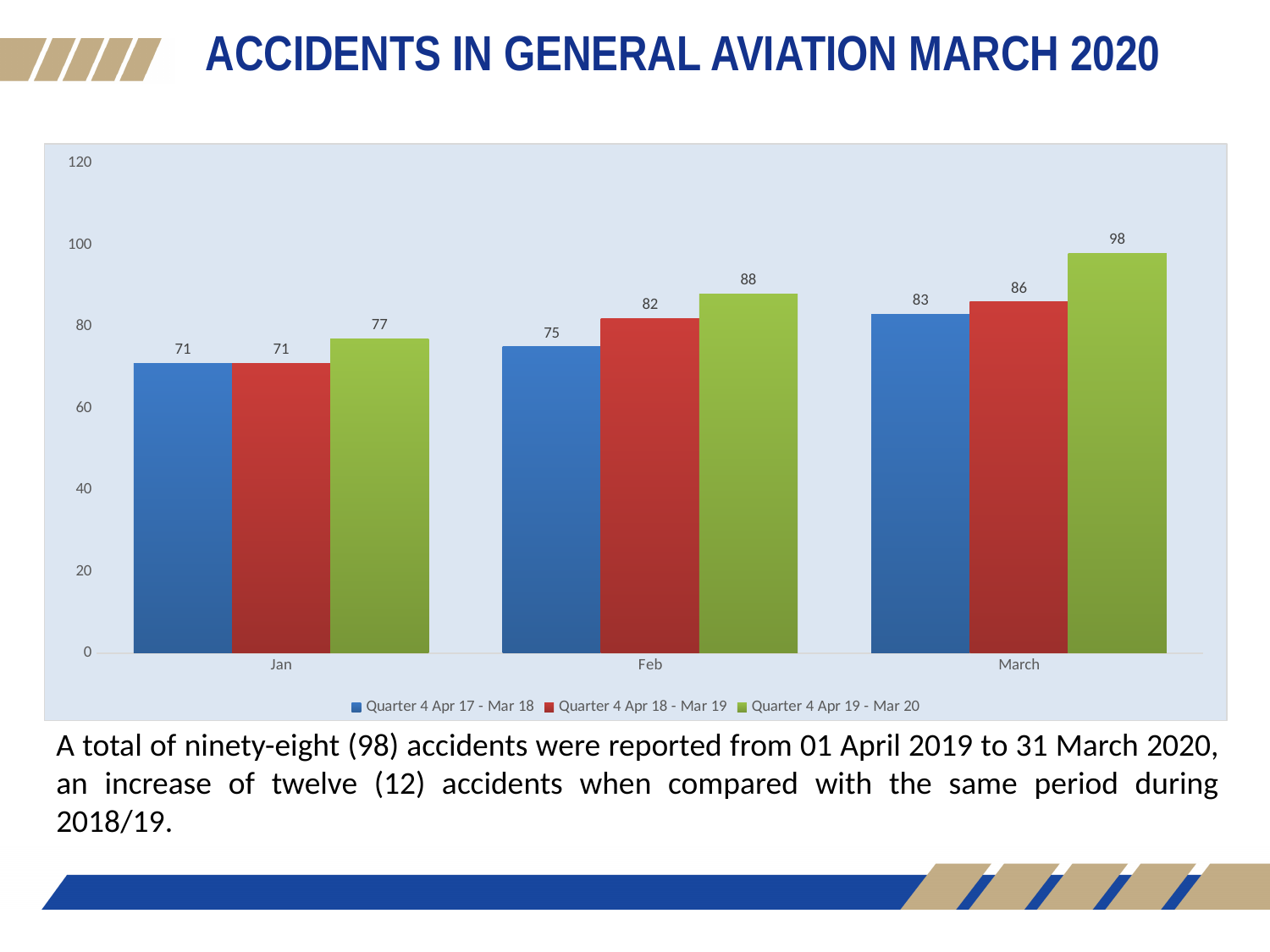
How many months are shown on the x axis? 3 Which month has the lowest value in the Quarter 4 Apr 17 - Mar 18 series? Jan Which month has the highest value in the Quarter 4 Apr 19 - Mar 20 series? March What is the value for March in the Quarter 4 Apr 19 - Mar 20 series? 98 What is the value for Feb in the Quarter 4 Apr 18 - Mar 19 series? 82 How many series does the legend list? 3 What kind of chart is shown on the slide? Bar chart Do the values in the Quarter 4 Apr 18 - Mar 19 series rise or fall from Jan to March? Rise What is the value for Jan in the Quarter 4 Apr 17 - Mar 18 series? 71 Is the value for March in the Quarter 4 Apr 17 - Mar 18 series greater or less than 80? greater Which is larger for Feb: the Quarter 4 Apr 17 - Mar 18 value or the Quarter 4 Apr 19 - Mar 20 value? Quarter 4 Apr 19 - Mar 20 What is the difference between the Quarter 4 Apr 19 - Mar 20 value and the Quarter 4 Apr 18 - Mar 19 value for March? 12